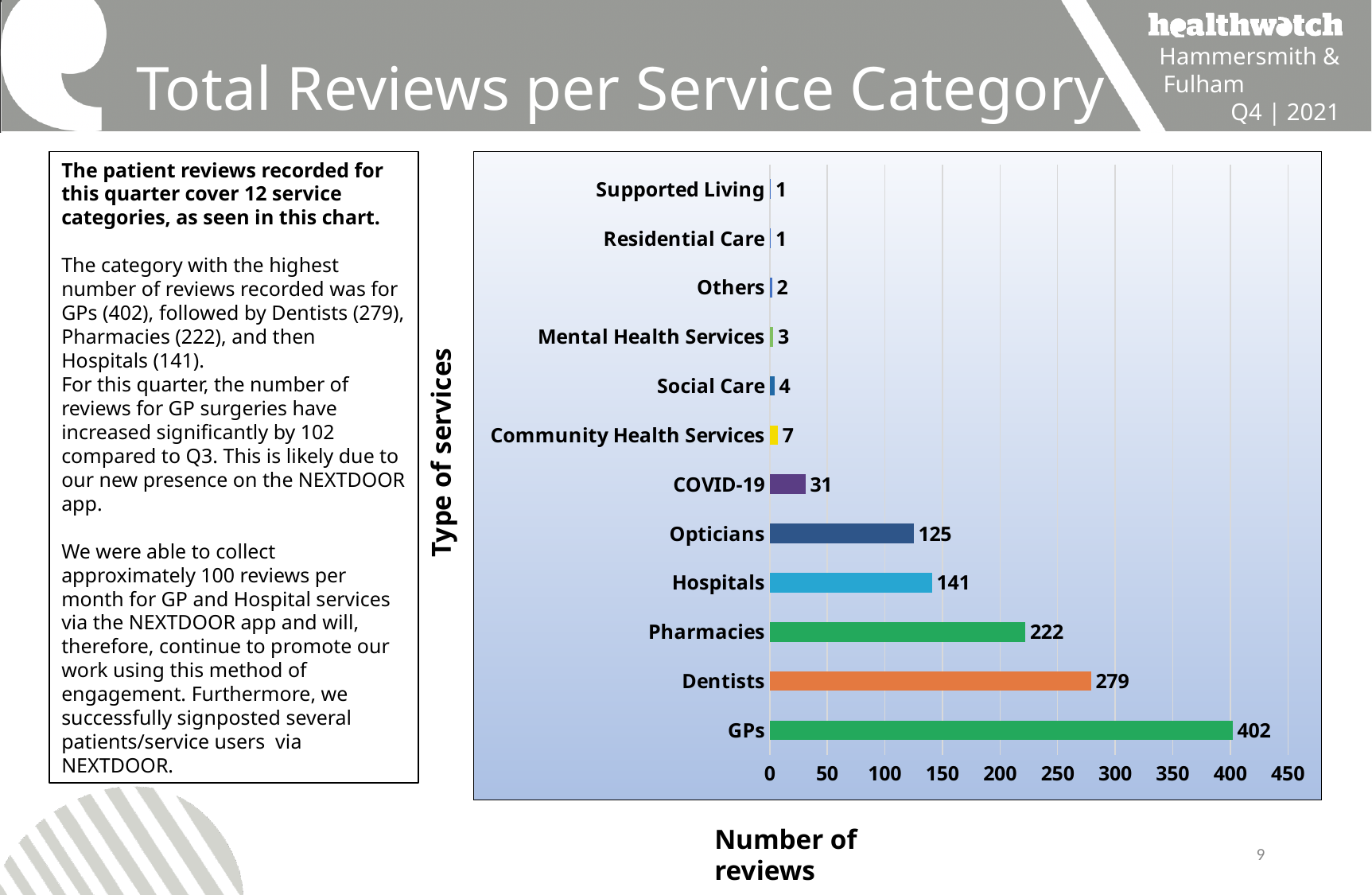
What is the label of the y axis of the chart? Type of services What type of chart is shown on the slide? Bar chart What is the difference in reviews between GPs and Hospitals? 261 How many reviews were recorded for GPs? 402 What is the difference in reviews between Dentists and Pharmacies? 57 How many reviews were recorded for Opticians? 125 What is the label of the x axis of the chart? Number of reviews Which has more reviews, Hospitals or Opticians? Hospitals How many reviews were recorded for COVID-19? 31 Which has more reviews, Community Health Services or Social Care? Community Health Services Which service category has the highest number of reviews? GPs How many service categories are shown in the chart? 12